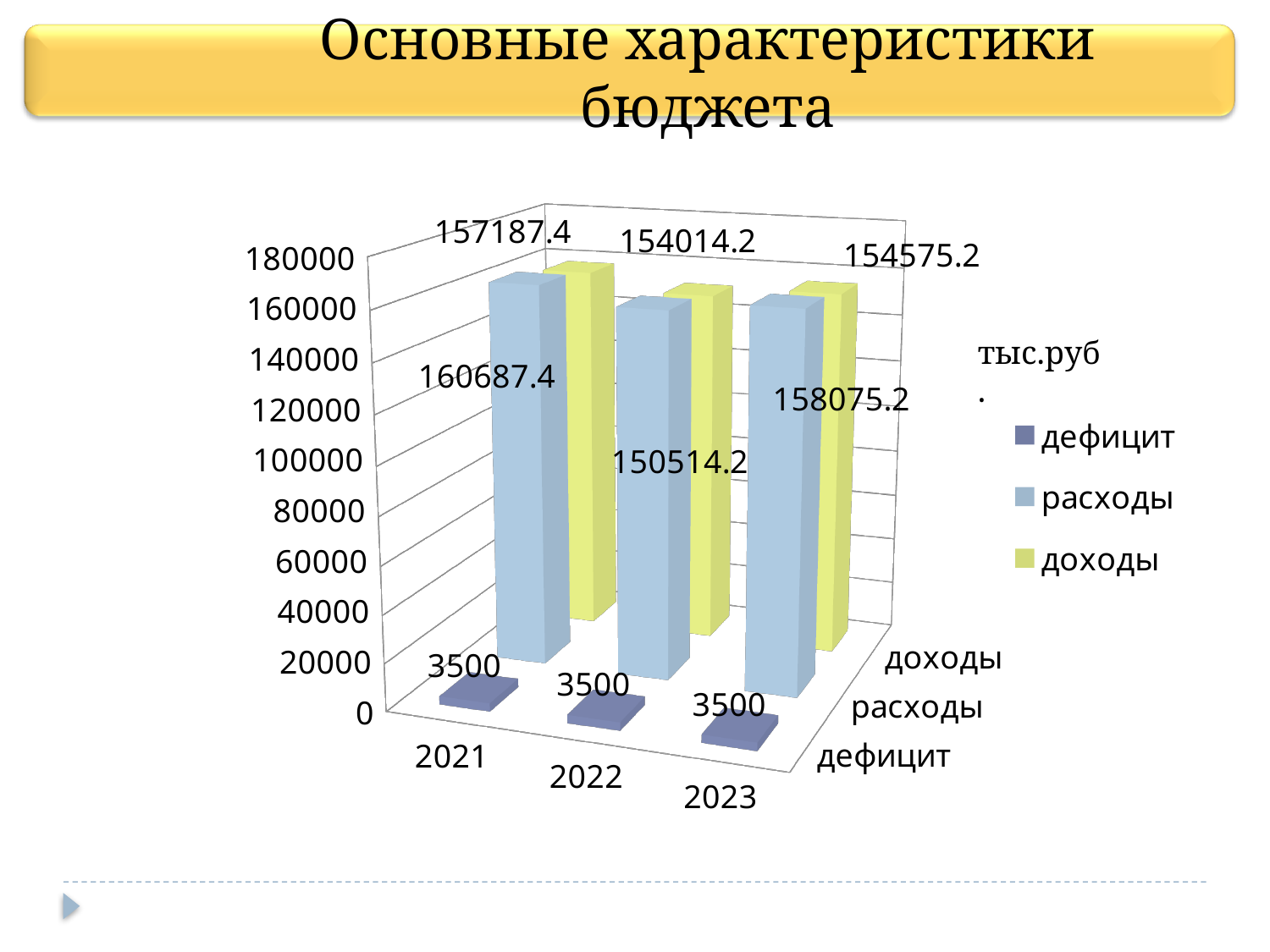
What is the value of доходы for 2023? 154575.2 In which year is доходы the highest? 2021 In which year is расходы the lowest? 2022 What is the value of дефицит for 2022? 3500 What is the difference between расходы and доходы in 2021? 3500 How many series does the legend list? 3 What is the value of доходы for 2021? 157187.4 What is the value of расходы for 2023? 158075.2 What is the difference between доходы in 2021 and доходы in 2022? 6673.2 How many years are shown on the x axis? 3 Which is larger, доходы in 2022 or доходы in 2023? 2023 What kind of chart is shown on the slide? bar chart